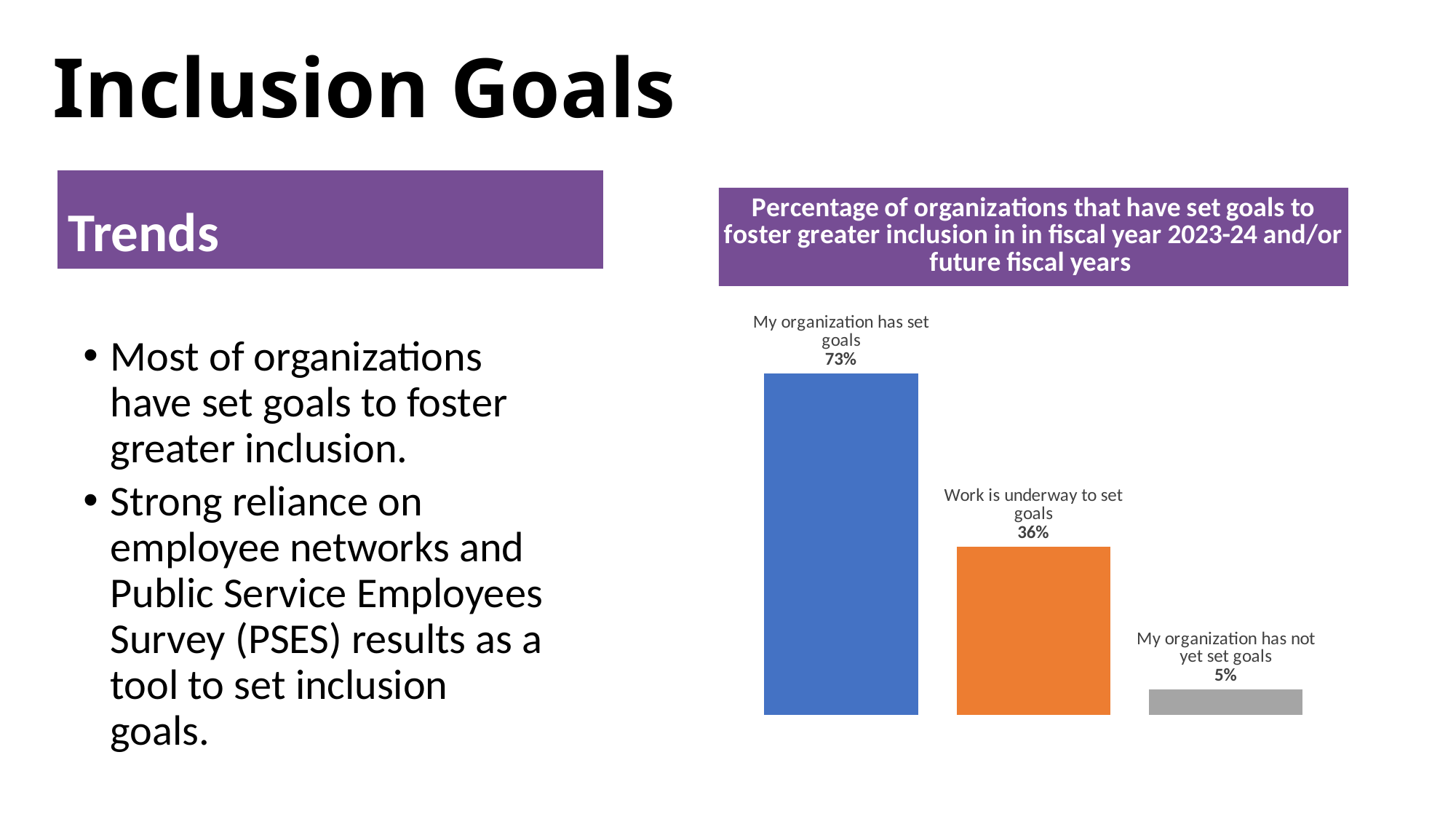
What percentage of organizations have not yet set goals? 5% What colour is the bar for "Work is underway to set goals"? Orange Which category has the highest value? My organization has set goals What is the value for "Work is underway to set goals"? 36% How many categories are shown in the chart? 3 What kind of chart is shown on the slide? Bar chart Which is larger: "Work is underway to set goals" or "My organization has not yet set goals"? Work is underway to set goals What percentage of organizations have set goals? 73% What is the difference between "Work is underway to set goals" and "My organization has not yet set goals"? 31% What is the difference between "My organization has set goals" and "Work is underway to set goals"? 37% Which category has the lowest value? My organization has not yet set goals Do the values rise or fall from left to right across the categories? Fall